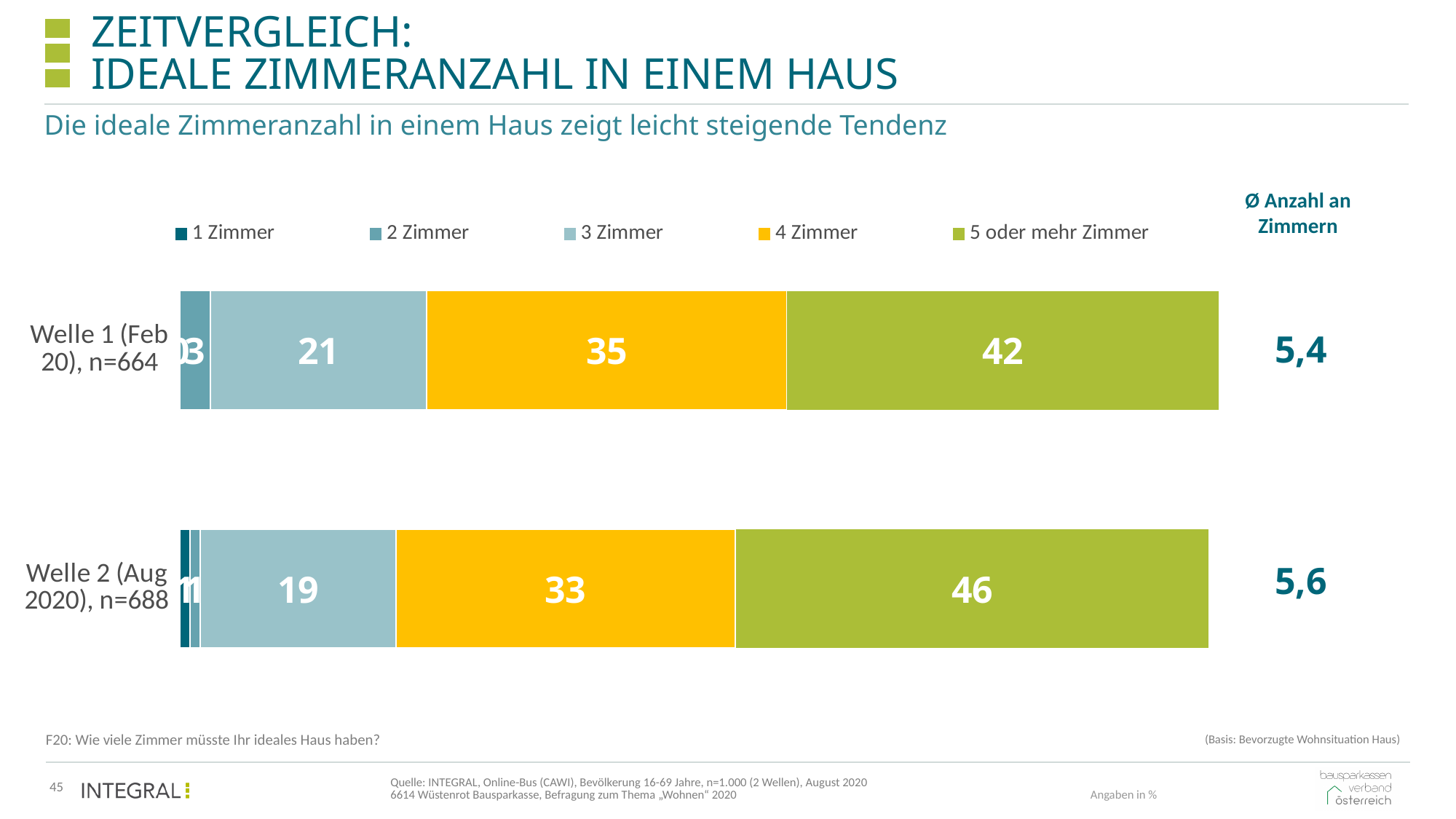
What is the value for '3 Zimmer' in Welle 2 (Aug 2020)? 19 How many bars (waves) are shown in the chart? 2 Which colour represents '4 Zimmer' in the chart? yellow Which wave has the larger value for '3 Zimmer', Welle 1 or Welle 2? Welle 1 (Feb 20) How many series does the legend list? 5 What is the average number of rooms (Ø Anzahl an Zimmern) shown for Welle 2 (Aug 2020)? 5,6 What is the difference between the '4 Zimmer' values of Welle 1 and Welle 2? 2 What is the value for '4 Zimmer' in Welle 1 (Feb 20)? 35 Which segment is the largest in the Welle 1 (Feb 20) bar? 5 oder mehr Zimmer What type of chart is shown on the slide? stacked bar chart What is the value for '5 oder mehr Zimmer' in Welle 2 (Aug 2020)? 46 By how much did the '5 oder mehr Zimmer' share increase from Welle 1 to Welle 2? 4